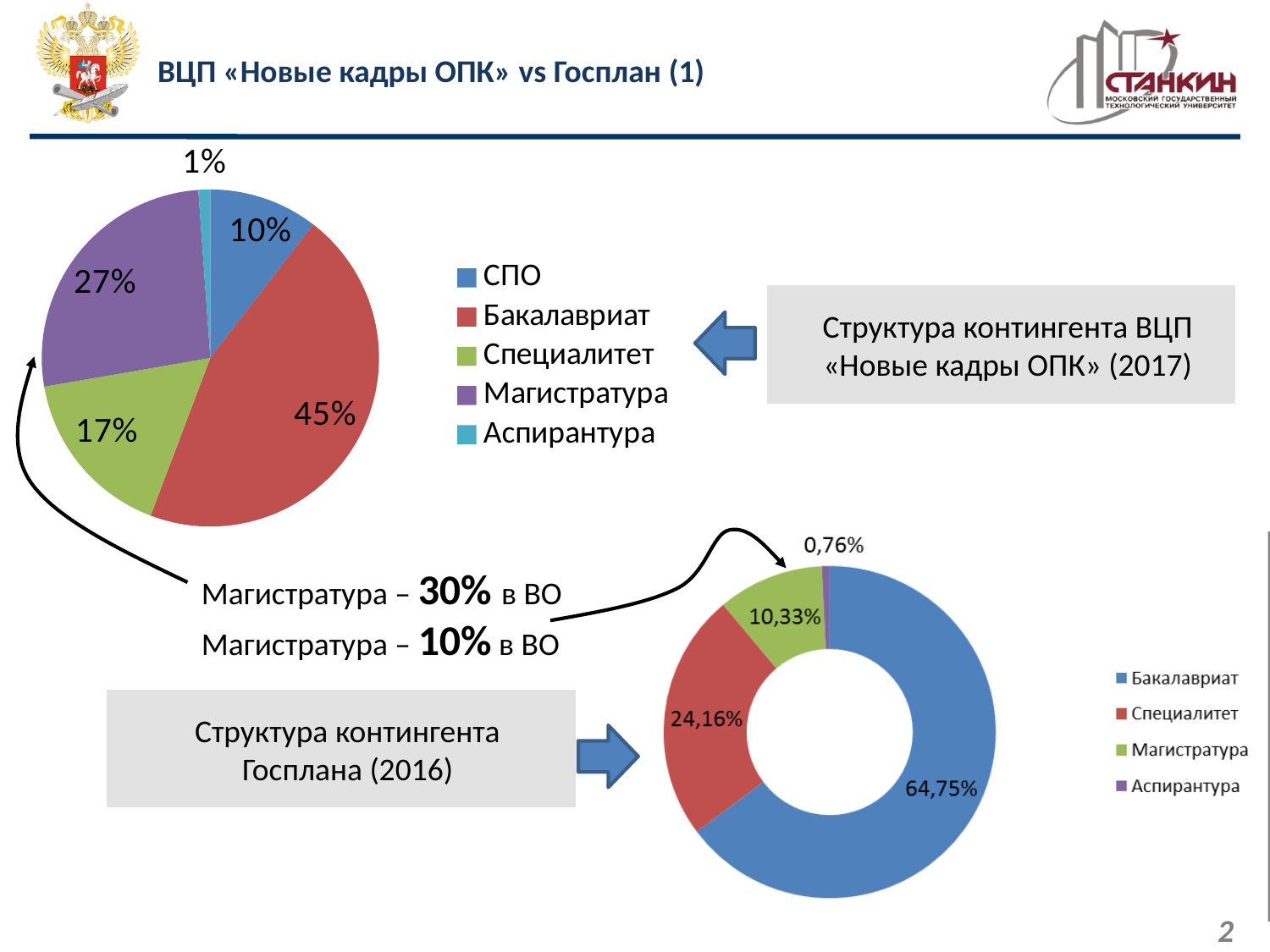
In the top-left pie chart, what share does Магистратура have? 27% In the bottom-right doughnut chart, what share does Магистратура have? 10,33% In the top-left pie chart, what is the difference between the shares of Магистратура and Специалитет? 10% In the top-left pie chart, which category has the largest share? Бакалавриат How many categories does the legend of the top-left pie chart list? 5 In the top-left pie chart (Структура контингента ВЦП «Новые кадры ОПК» (2017)), what share does Бакалавриат have? 45% In the bottom-right doughnut chart, which category has the smallest share? Аспирантура In the bottom-right doughnut chart, which is larger: Специалитет or Магистратура? Специалитет What type of chart is the top-left chart on the slide? Pie chart In the top-left pie chart, which category has the smallest share? Аспирантура In the bottom-right doughnut chart (Структура контингента Госплана (2016)), what share does Бакалавриат have? 64,75% How many categories does the legend of the bottom-right doughnut chart list? 4